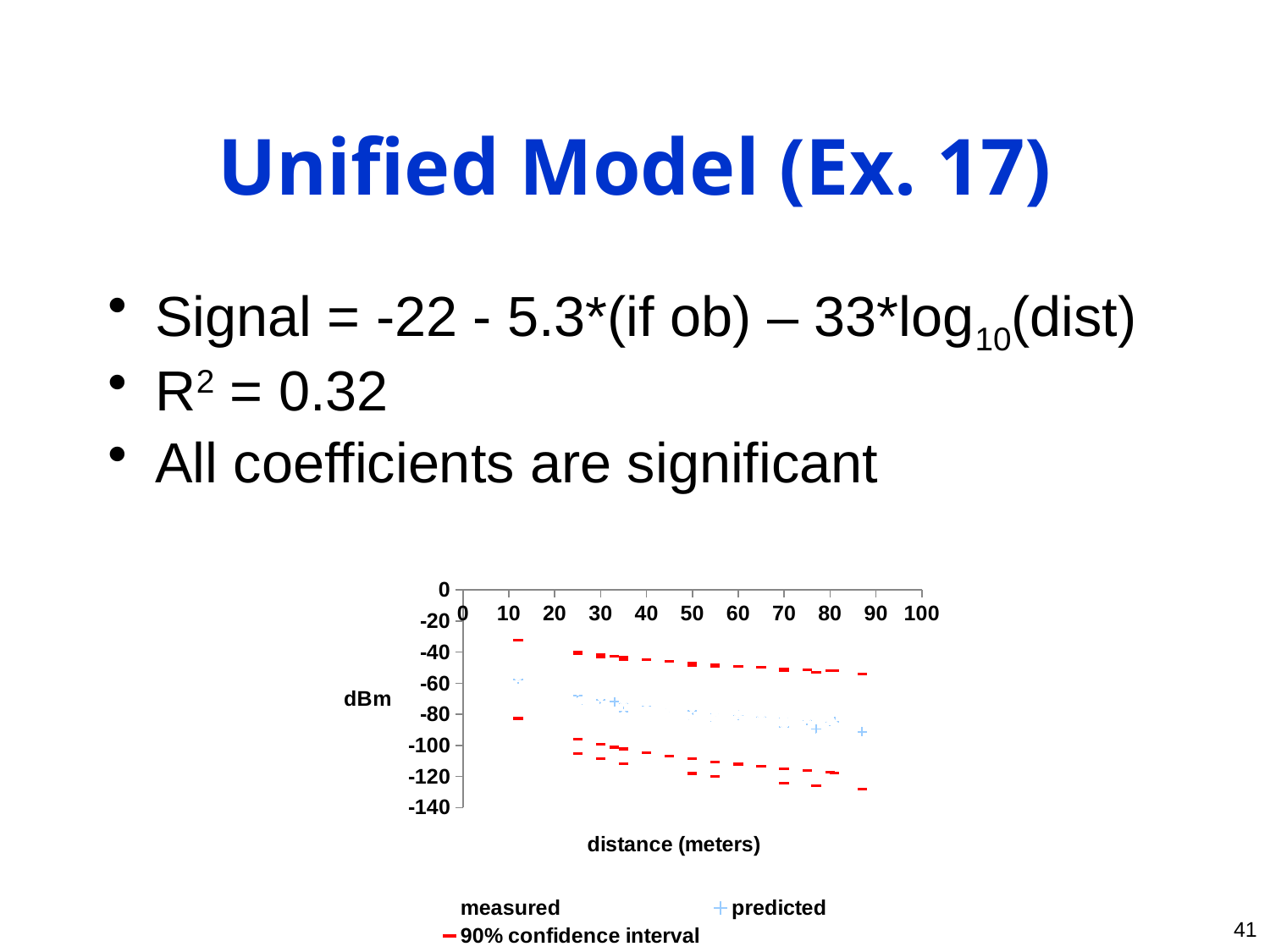
Do the predicted values rise or fall as distance increases along the x axis? fall Is the upper 90% confidence interval value at about 90 meters greater or less than -60? greater Is the predicted value at about 87 meters greater or less than -80? less Does the lower 90% confidence interval bound rise or fall as distance increases? fall Is the upper 90% confidence interval value at about 10 meters greater or less than -40? greater What kind of chart is shown on the slide? scatter chart What is the title of the chart's x axis? distance (meters) How many series does the chart's legend list? 3 What label is shown on the chart's y axis? dBm